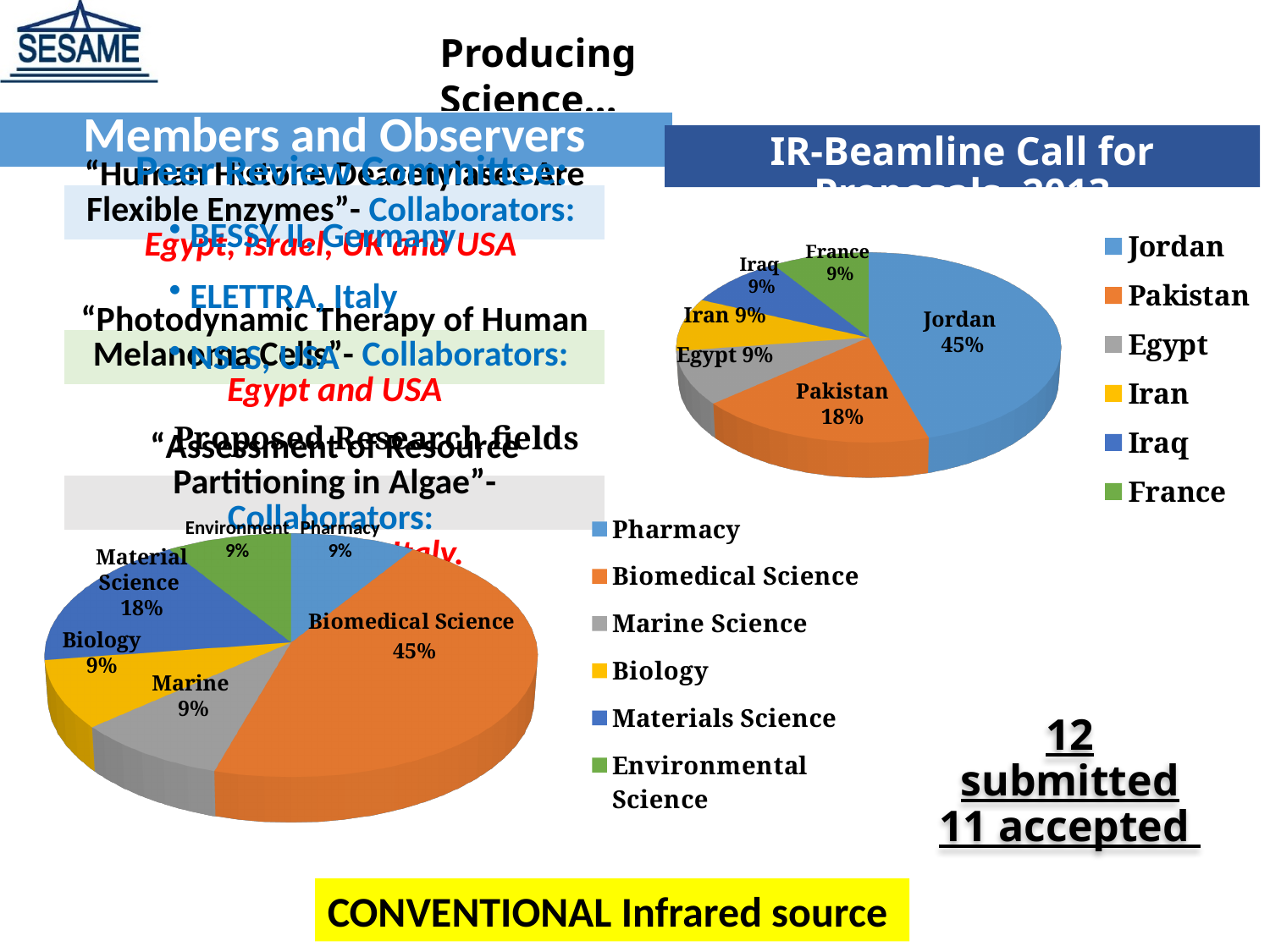
What kind of chart is shown in the lower left of the slide? Pie chart On the pie chart in the upper right of the slide, what share is labelled for Pakistan? 18% On the pie chart in the lower left of the slide, what share is labelled for Biomedical Science? 45% On the pie chart in the lower left of the slide, how many research fields does the legend list? 6 On the pie chart in the upper right of the slide, what is the difference in percentage points between Jordan and Pakistan? 27 On the pie chart in the upper right of the slide, how many countries does the legend list? 6 On the pie chart in the upper right of the slide, which is larger, the slice for Pakistan or the slice for Egypt? Pakistan On the pie chart in the upper right of the slide, what share is labelled for Jordan? 45% On the pie chart in the lower left of the slide, what colour is the Biomedical Science slice? Orange On the pie chart in the lower left of the slide, which research field has the largest slice? Biomedical Science On the pie chart in the upper right of the slide, which country has the largest slice? Jordan On the pie chart in the lower left of the slide, what share is labelled for Material Science? 18%